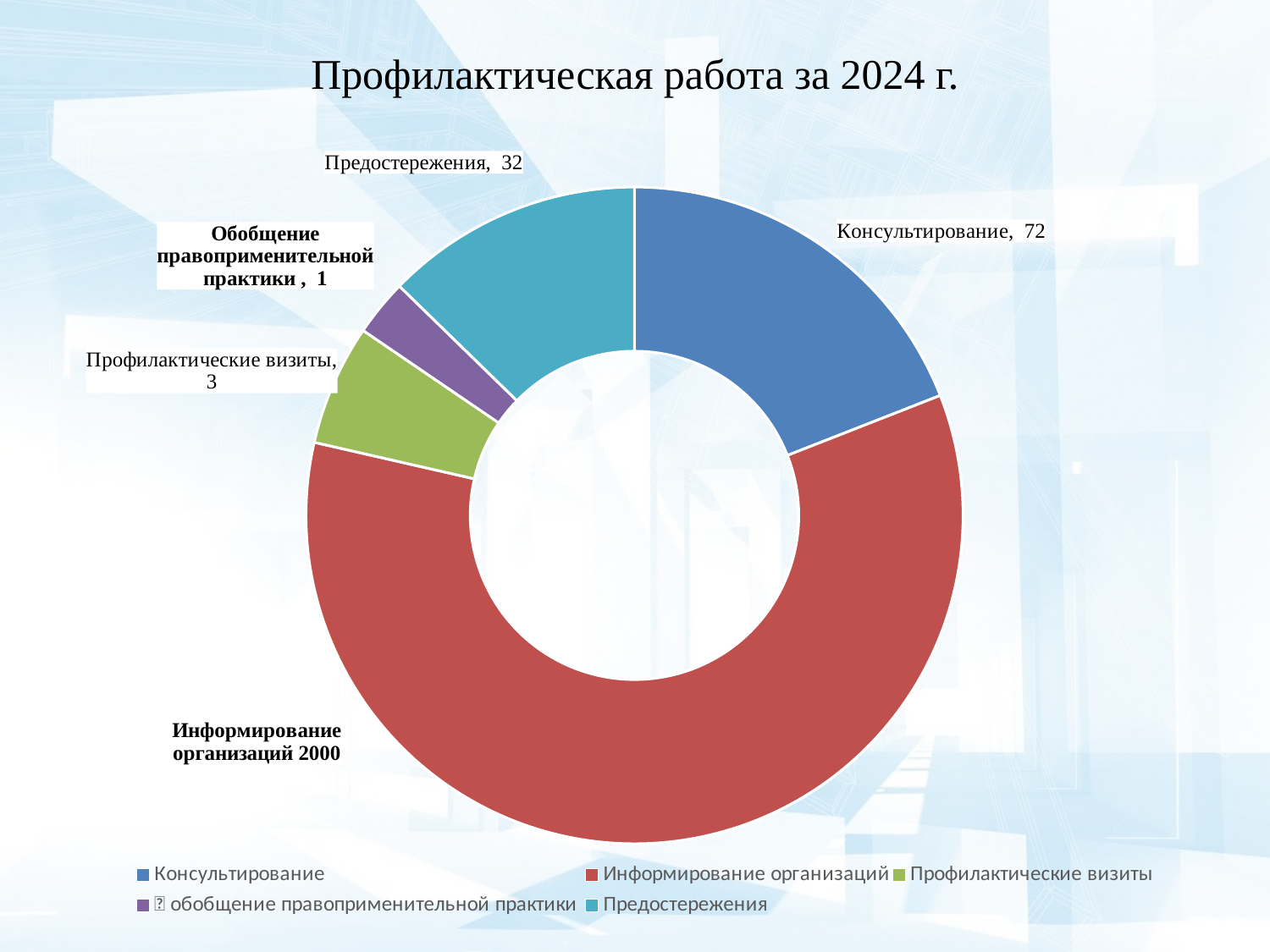
What is the value for Профилактические визиты? 3 What is the difference between the values for Предостережения and Профилактические визиты? 29 Which category has the largest value? Информирование организаций What is the title of the slide? Профилактическая работа за 2024 г. What is the value for Предостережения? 32 Which is larger, Консультирование or Предостережения? Консультирование What is the difference between the values for Консультирование and Предостережения? 40 What kind of chart is shown on the slide? Doughnut (pie) chart What is the value for Информирование организаций? 2000 What is the value for Консультирование? 72 Which category has the smallest value? Обобщение правоприменительной практики How many categories are shown in the chart? 5